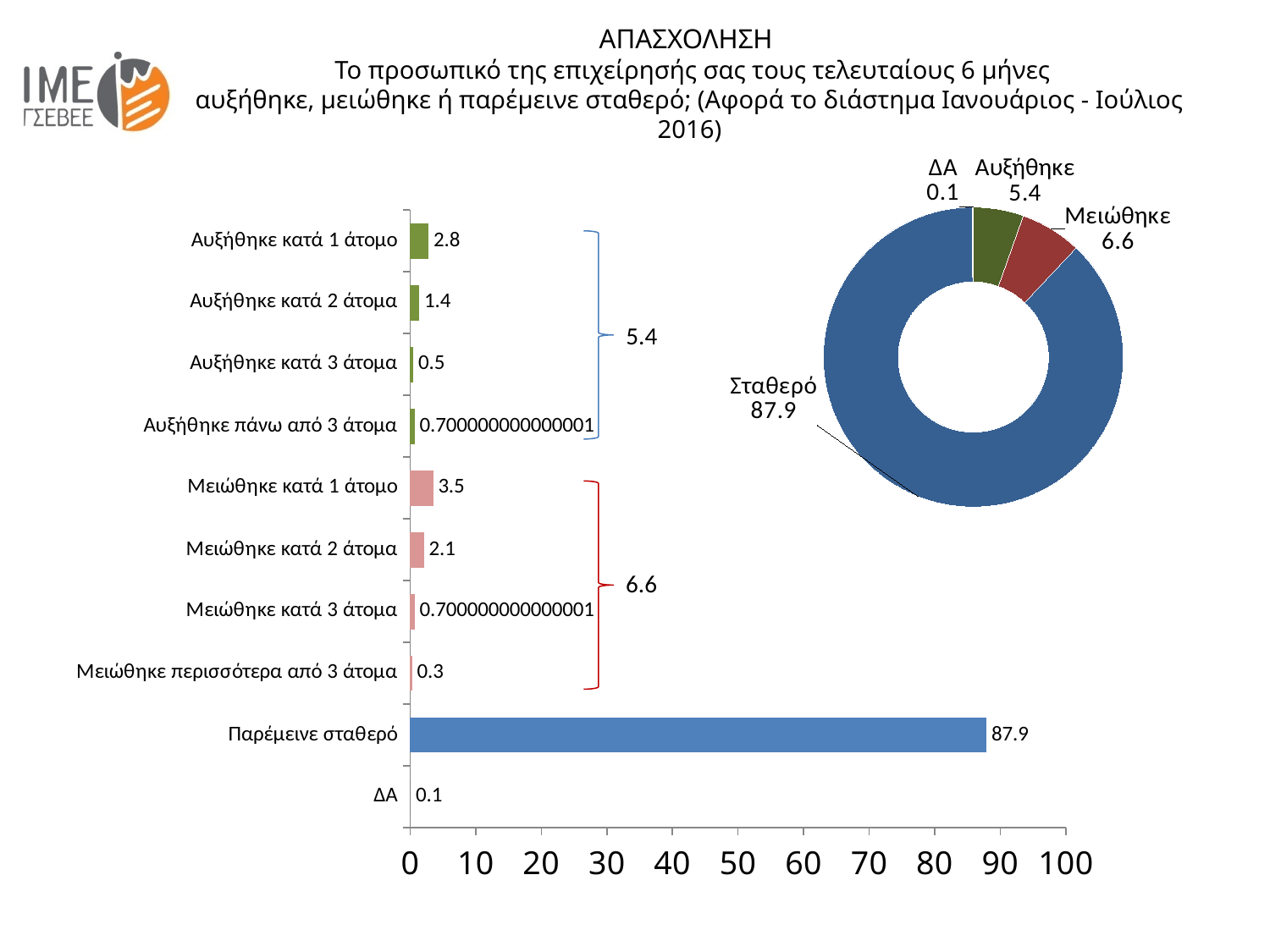
In the bar chart on the left, is the value for Παρέμεινε σταθερό greater or less than 80? greater What kind of chart is shown on the left of the slide? bar chart In the doughnut chart on the right, what is the value for Μειώθηκε? 6.6 In the bar chart on the left, what is the value for Αυξήθηκε κατά 1 άτομο? 2.8 In the bar chart on the left, what is the difference between Μειώθηκε κατά 1 άτομο and Αυξήθηκε κατά 1 άτομο? 0.7 In the doughnut chart on the right, what is the value for Αυξήθηκε? 5.4 How many categories does the bar chart on the left show? 10 In the bar chart on the left, which category has the highest value? Παρέμεινε σταθερό In the bar chart on the left, what is the value for Μειώθηκε κατά 1 άτομο? 3.5 In the bar chart on the left, which category has the lowest value? ΔΑ In the bar chart on the left, what is the value for Παρέμεινε σταθερό? 87.9 In the bar chart on the left, which is larger: Αυξήθηκε κατά 2 άτομα or Μειώθηκε κατά 2 άτομα? Μειώθηκε κατά 2 άτομα